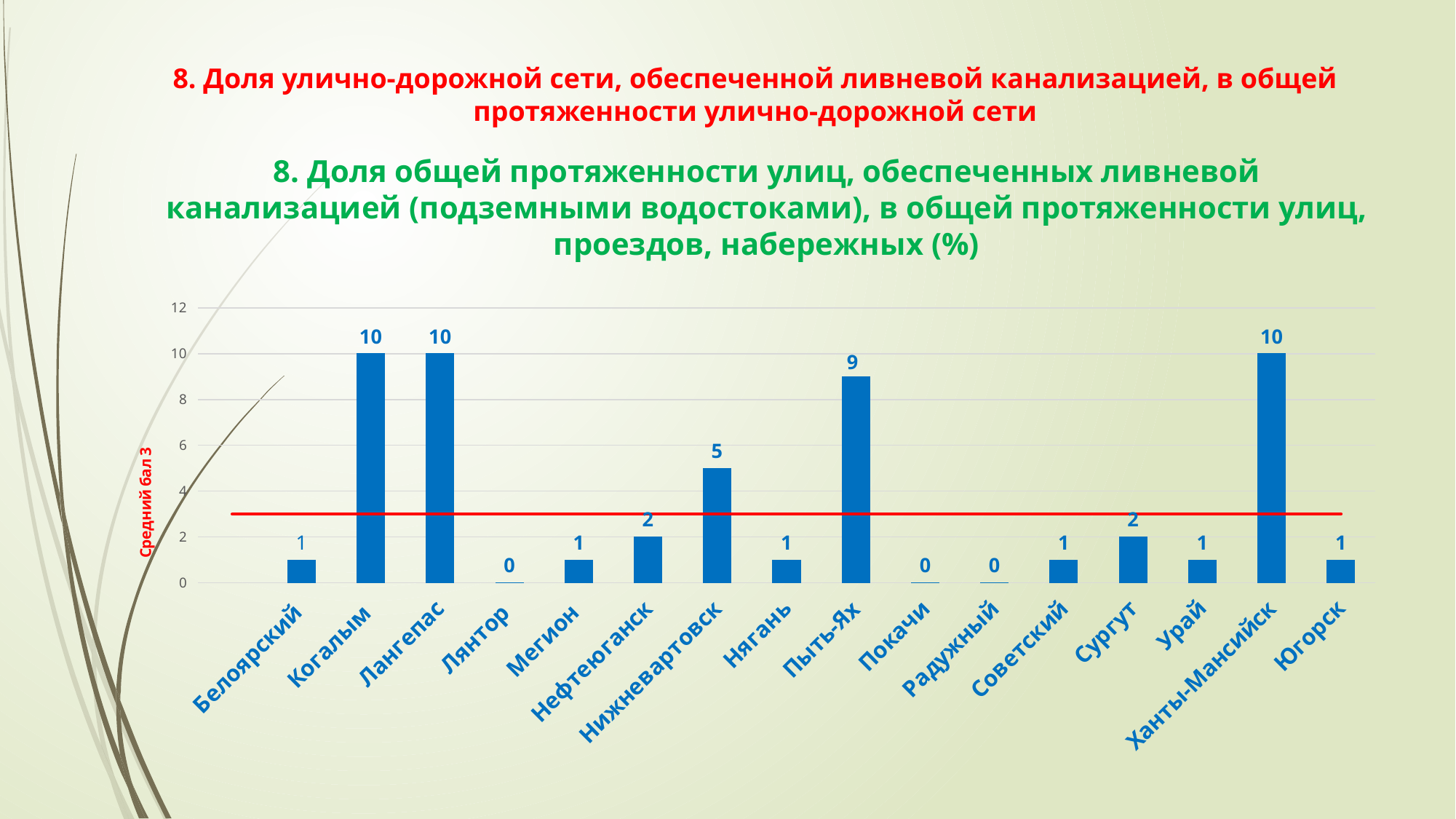
What is the value for Пыть-Ях? 9 What is the value for Нижневартовск? 5 What kind of chart is shown on the slide? Combination bar and line chart (bars with a red horizontal line) What does the red horizontal line on the chart represent? Средний бал 3 What is the value for Нефтеюганск? 2 What is the total of the values for Когалым and Лангепас? 20 How many categories are shown on the x axis? 16 What is the value for Лянтор? 0 What is the value for Ханты-Мансийск? 10 What is the difference between the values for Пыть-Ях and Нижневартовск? 4 Which categories have the highest value on the chart? Когалым, Лангепас, Ханты-Мансийск Which is larger, the value for Сургут or the value for Урай? Сургут